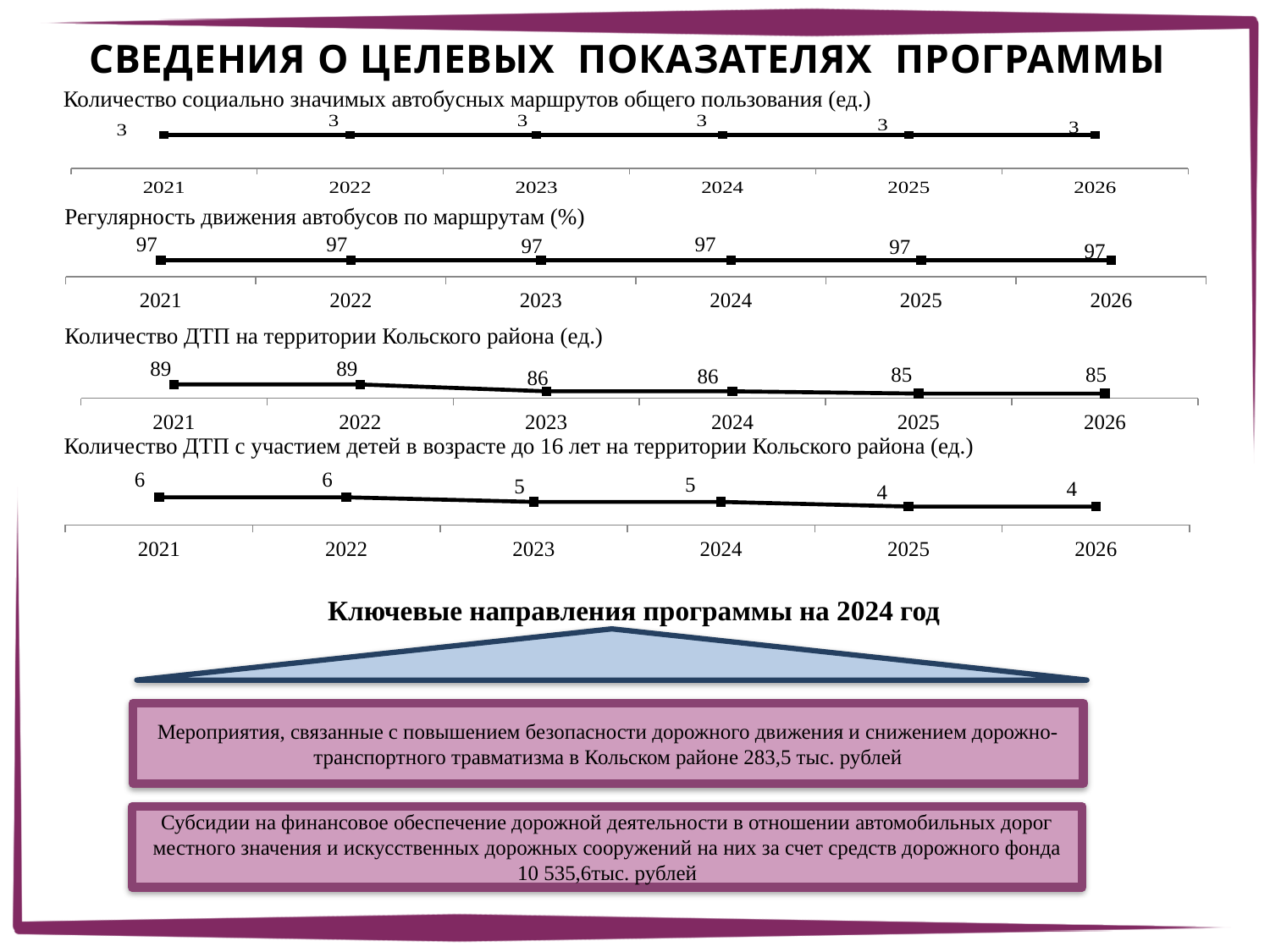
In the chart 'Количество ДТП на территории Кольского района (ед.)', what is the value for 2023? 86 In the chart 'Количество социально значимых автобусных маршрутов общего пользования (ед.)', what is the value for 2026? 3 How many years (data points) are shown in the chart 'Регулярность движения автобусов по маршрутам (%)'? 6 In the chart 'Количество ДТП на территории Кольского района (ед.)', is the value for 2022 larger or smaller than the value for 2025? larger What type of chart is 'Количество ДТП на территории Кольского района (ед.)'? line chart In the chart 'Регулярность движения автобусов по маршрутам (%)', what is the value for 2024? 97 In the chart 'Количество ДТП с участием детей в возрасте до 16 лет на территории Кольского района (ед.)', which year has the highest value? 2021 and 2022 (both 6) How many charts are shown on the slide? 4 In the chart 'Количество ДТП с участием детей в возрасте до 16 лет на территории Кольского района (ед.)', what is the value for 2025? 4 In the chart 'Количество ДТП с участием детей в возрасте до 16 лет на территории Кольского района (ед.)', what is the difference between the values for 2021 and 2026? 2 In the chart 'Количество ДТП на территории Кольского района (ед.)', do the values rise or fall from 2021 to 2026? fall In the chart 'Количество ДТП на территории Кольского района (ед.)', what is the difference between the values for 2021 and 2026? 4